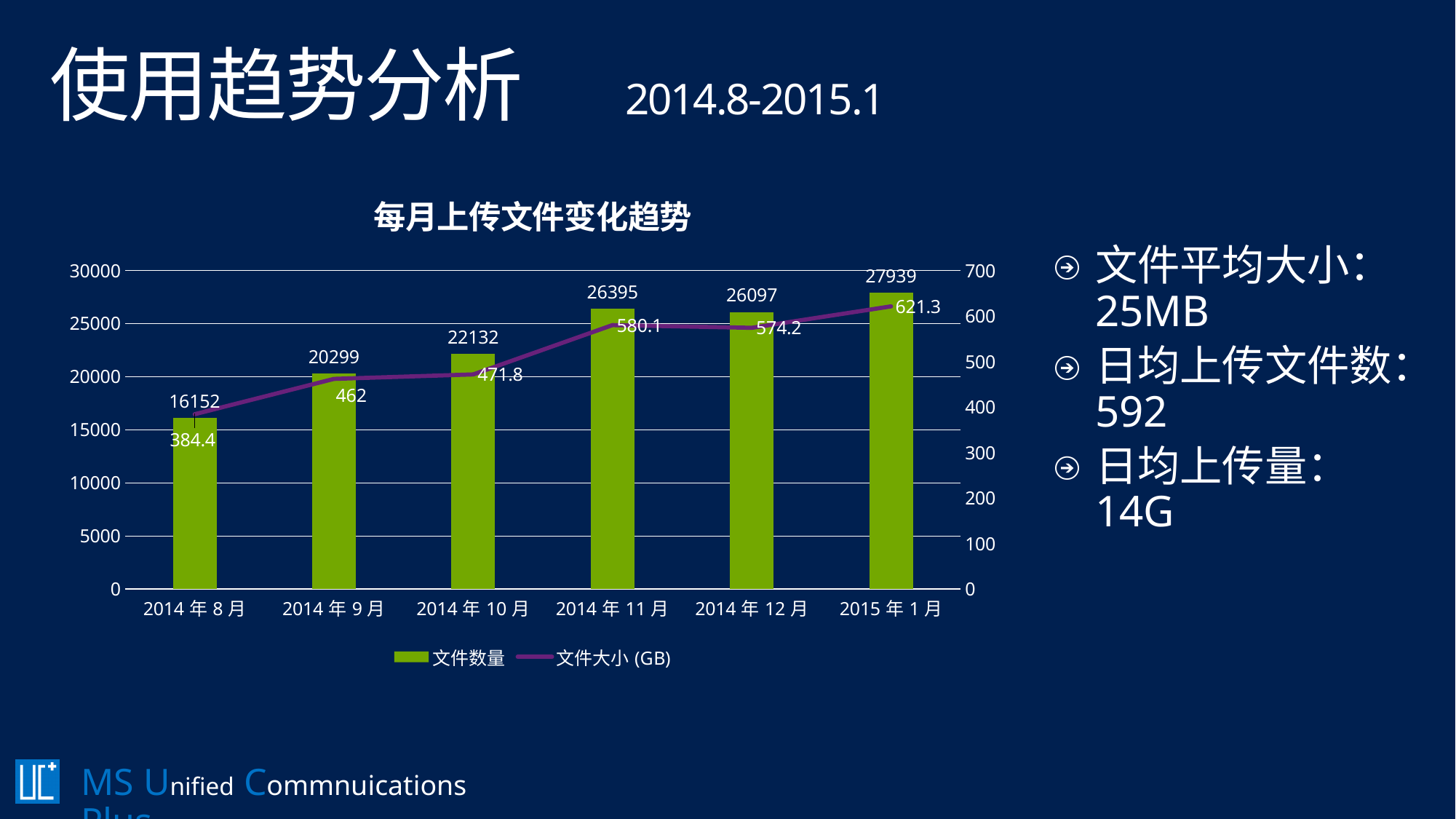
How many months are shown on the x axis of the chart? 6 What is the title of the chart? 每月上传文件变化趋势 What is the difference in 文件数量 between 2015 年 1 月 and 2014 年 8 月? 11787 Which month has the lowest 文件大小 (GB)? 2014 年 8 月 What kind of chart is used to show 文件数量? bar chart What is the value of 文件大小 (GB) for 2014 年 8 月? 384.4 Which month has the highest 文件数量? 2015 年 1 月 What is the value of 文件数量 for 2014 年 11 月? 26395 How many series does the chart legend list? 2 Which is larger, the 文件数量 for 2014 年 11 月 or for 2014 年 12 月? 2014 年 11 月 Does 文件大小 (GB) generally rise or fall from 2014 年 8 月 to 2015 年 1 月? rise What is the value of 文件大小 (GB) for 2015 年 1 月? 621.3